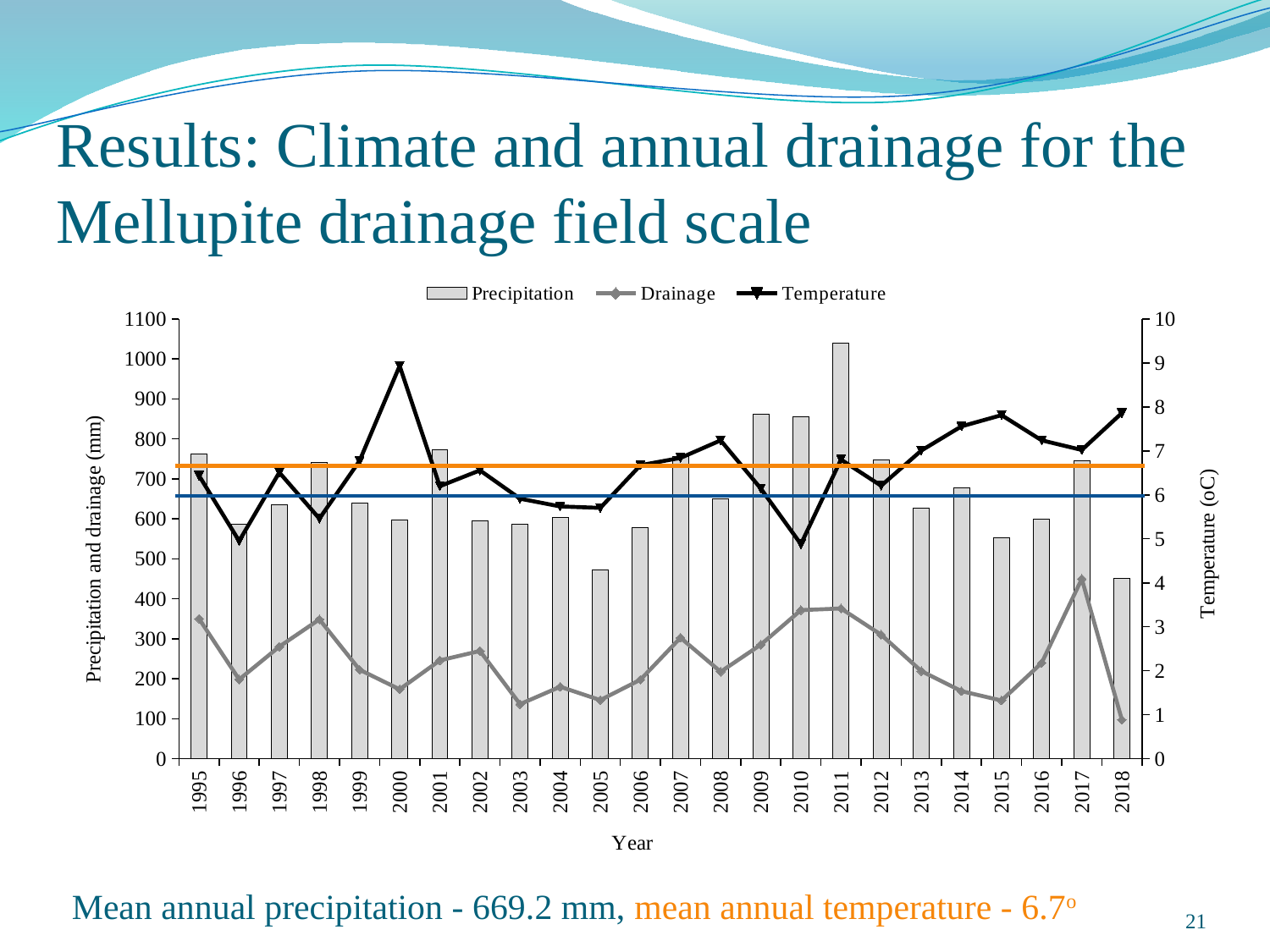
Is the precipitation value for 2011 greater or less than 1000? greater Which year has the highest temperature value? 2000 Which year has the larger precipitation bar, 1995 or 1996? 1995 Does the drainage value rise or fall from 2017 to 2018? fall Is the temperature value for 2000 greater or less than 8? greater Which year has the highest drainage value? 2017 What kind of chart is shown on the slide? A combined bar and line chart Is the precipitation value for 2005 greater or less than 500? less Which year has the lowest drainage value? 2018 How many years are shown on the x axis? 24 Which year has the highest precipitation bar? 2011 How many series does the legend list? 3